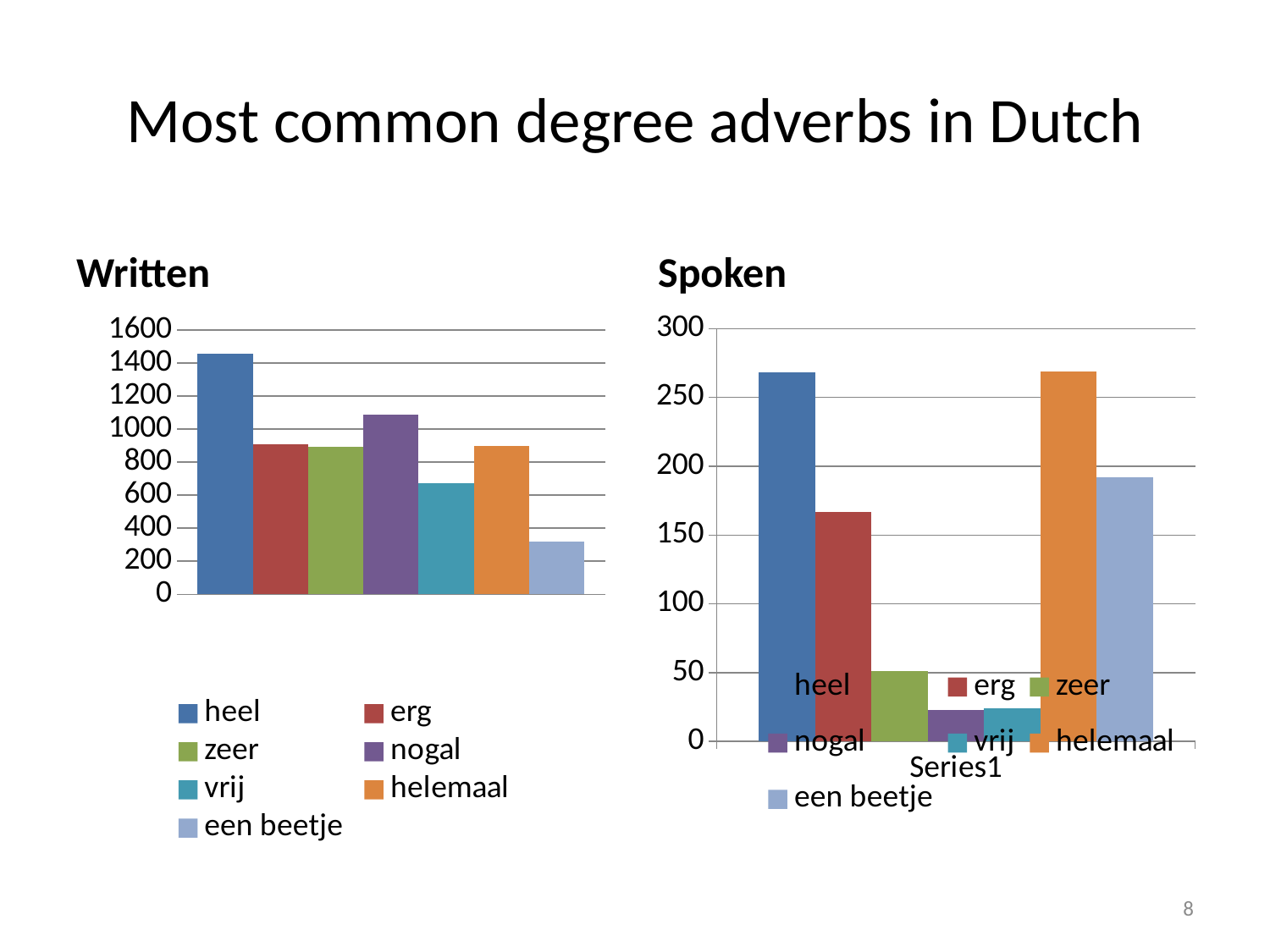
In the Written chart, which adverb has the lowest value? een beetje In the Written chart, which adverb has the highest value? heel How many series does the legend of the Spoken chart list? 7 In the Written chart, which is larger, the value for nogal or the value for erg? nogal In the Written chart, is the value for heel greater or less than 1400? greater In the Spoken chart, is the value for erg greater or less than 150? greater What is the title of the slide containing the two charts? Most common degree adverbs in Dutch What kind of chart is the Written chart? bar chart In the Spoken chart, is the value for heel greater or less than 250? greater In the Spoken chart, which is larger, the value for erg or the value for een beetje? een beetje